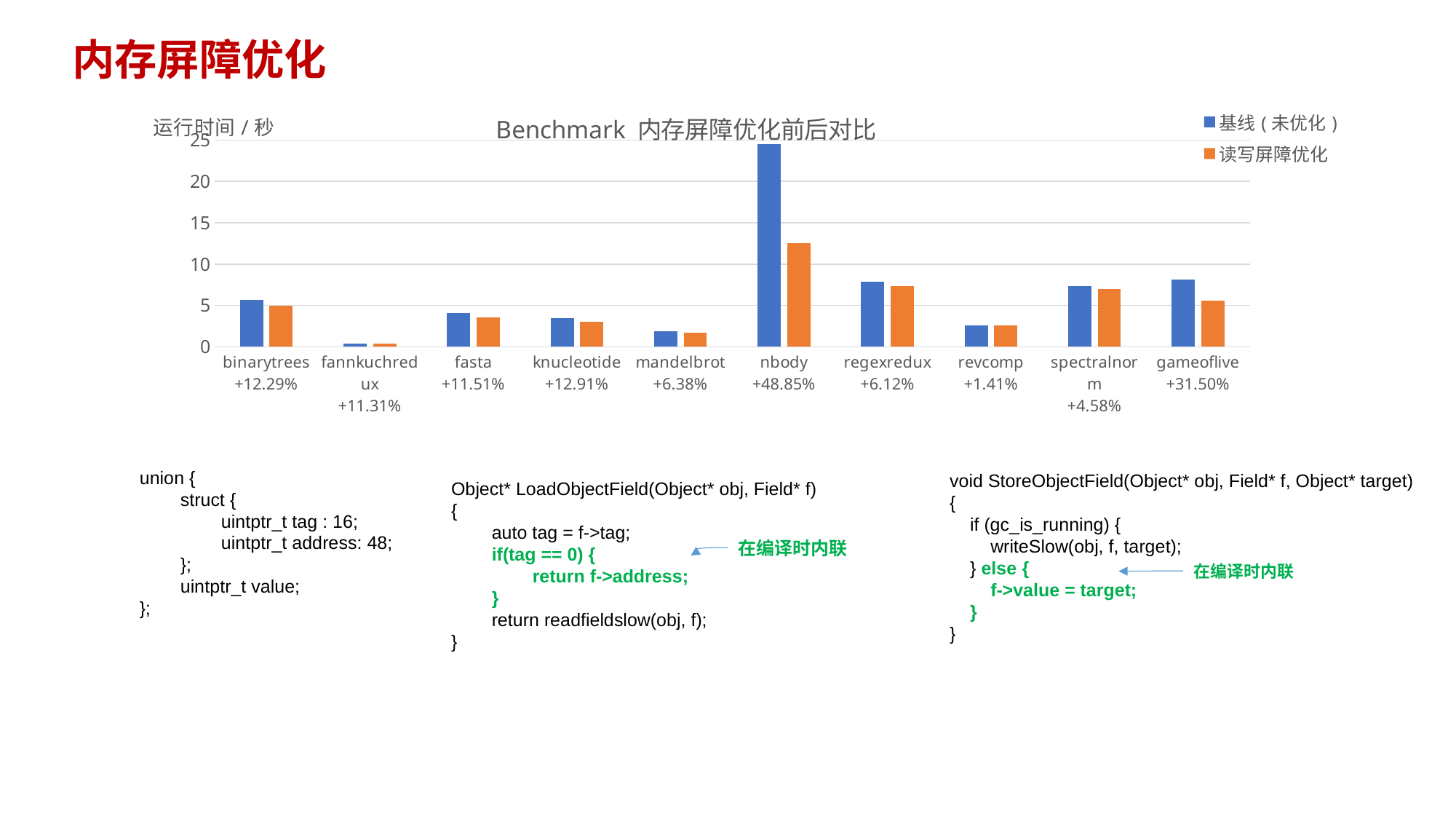
What is the title of the chart? Benchmark 内存屏障优化前后对比 Which benchmark has the highest 基线（未优化） running time? nbody Is the 基线（未优化） value for nbody greater or less than 20? greater What improvement percentage is printed under the gameoflive category label? +31.50% Is the 读写屏障优化 value for nbody greater or less than 10? greater What kind of chart is shown on the slide? bar chart Which benchmark has the lowest 基线（未优化） running time? fannkuchredux How many benchmark categories are plotted on the x axis? 10 How many series does the chart legend list? 2 For nbody, which series has the larger value, 基线（未优化） or 读写屏障优化? 基线（未优化） What improvement percentage is printed under the nbody category label? +48.85%